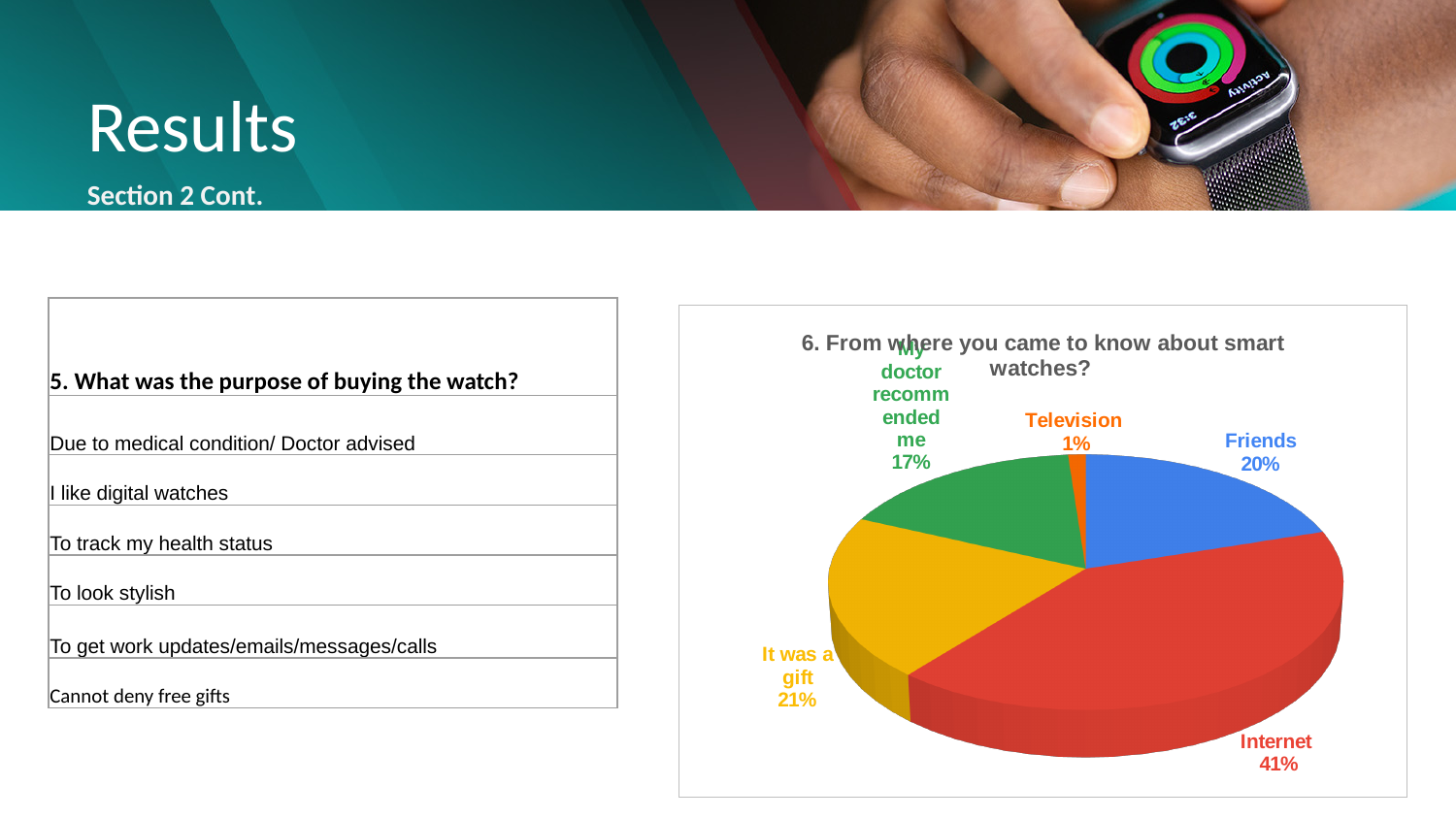
Which is larger, the share for 'It was a gift' or the share for 'My doctor recommended me'? It was a gift What type of chart is shown on the slide? Pie chart What share of the pie is labelled Friends? 20% What is the difference in percentage points between Internet and Friends? 21 What percentage is shown for 'My doctor recommended me'? 17% How many slices does the pie chart have? 5 Which source has the smallest share of the pie? Television What percentage is shown for 'It was a gift'? 21% What is the title of the pie chart? 6. From where you came to know about smart watches? What percentage is shown for Television? 1% What percentage of respondents came to know about smart watches from the Internet? 41% Which source has the largest share of the pie? Internet